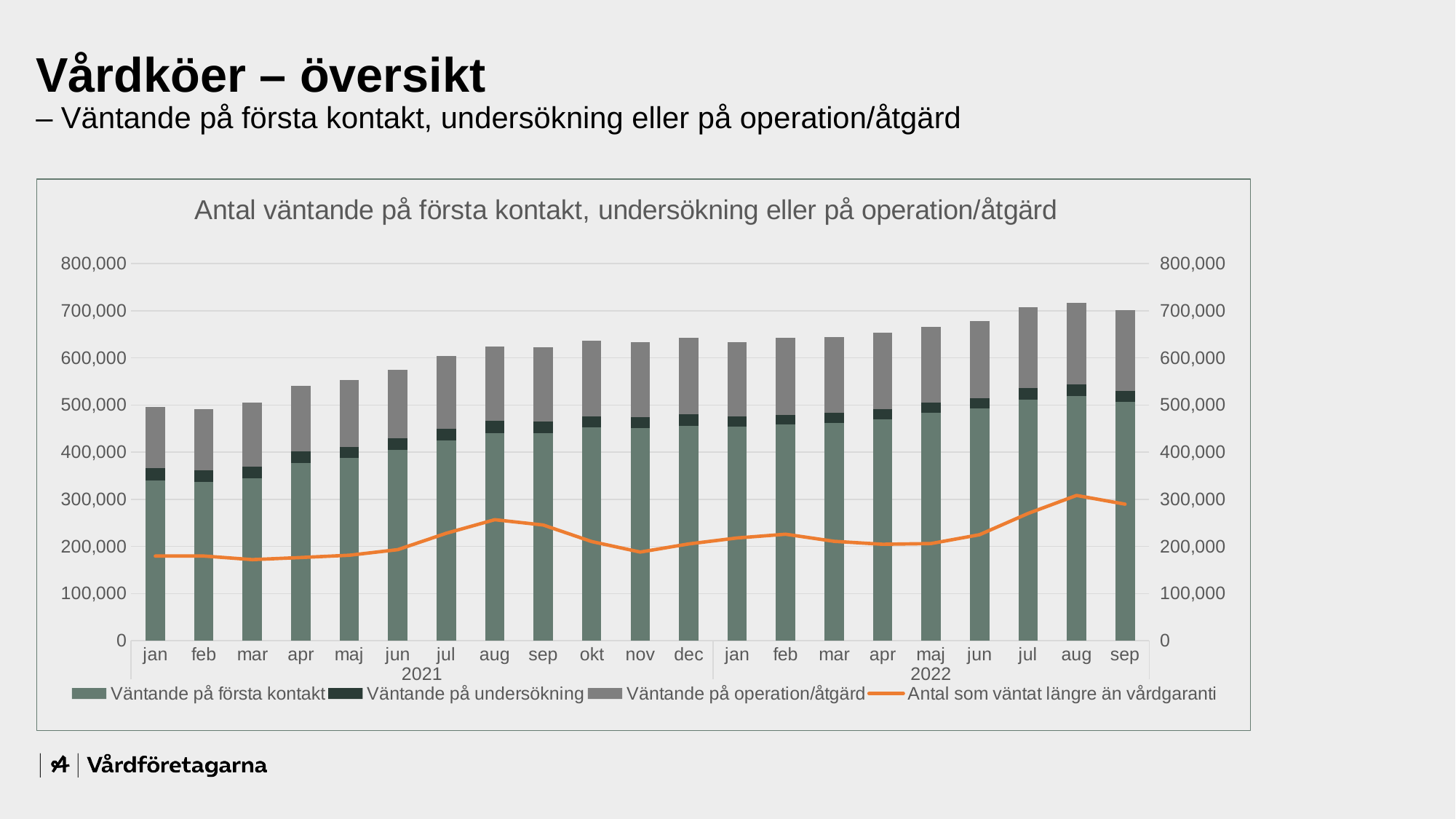
Is the value of the line 'Antal som väntat längre än vårdgaranti' for aug 2021 greater or less than 200,000? greater Do the total stacked bars generally rise or fall from jan 2021 to sep 2022? rise How many series does the legend list? 4 What kind of chart is shown on the slide? Stacked bar chart with a line Is the value of the line 'Antal som väntat längre än vårdgaranti' for mar 2021 greater or less than 200,000? less How many months are plotted along the x axis? 21 Is the total stacked bar for feb 2021 greater or less than 500,000? less Which month has the highest total stacked bar? aug 2022 Which has the larger total stacked bar, jun 2022 or jul 2022? jul 2022 Which month has the higher value on the line 'Antal som väntat längre än vårdgaranti', aug 2021 or nov 2021? aug 2021 Which series is drawn as a line rather than as bars? Antal som väntat längre än vårdgaranti